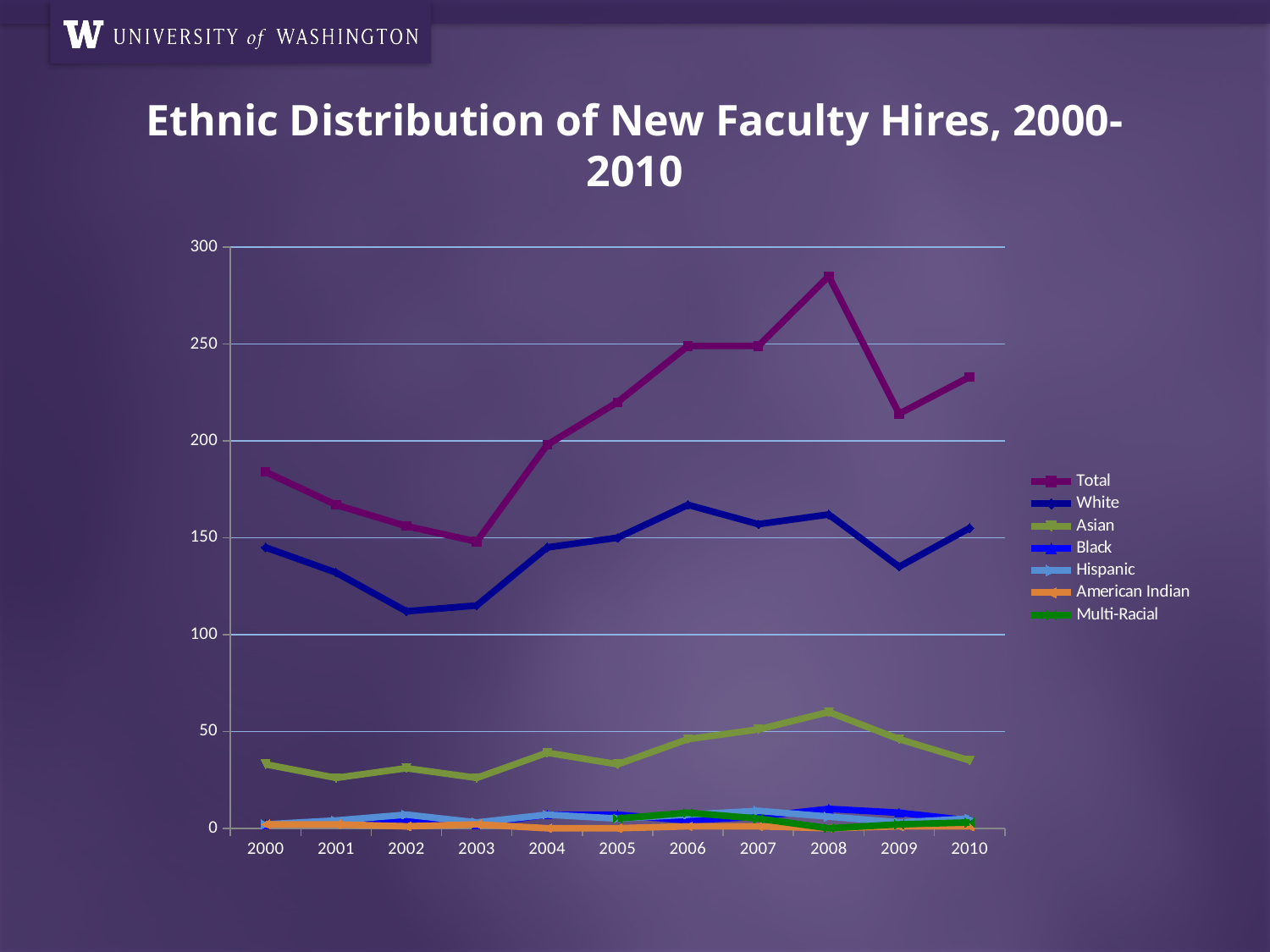
In which year is the Total series at its highest? 2008 In which year is the Total series at its lowest? 2003 Does the Total series rise or fall from 2003 to 2008? rise What kind of chart is shown on the slide? Line chart Is the Asian value for 2008 greater or less than 50? greater Is the Total value for 2008 greater or less than 250? greater Which year has the larger Total value, 2003 or 2006? 2006 In which year does the Asian series reach its peak? 2008 Is the Total value for 2000 greater or less than 150? greater How many series does the legend list? 7 How many years are plotted along the x axis? 11